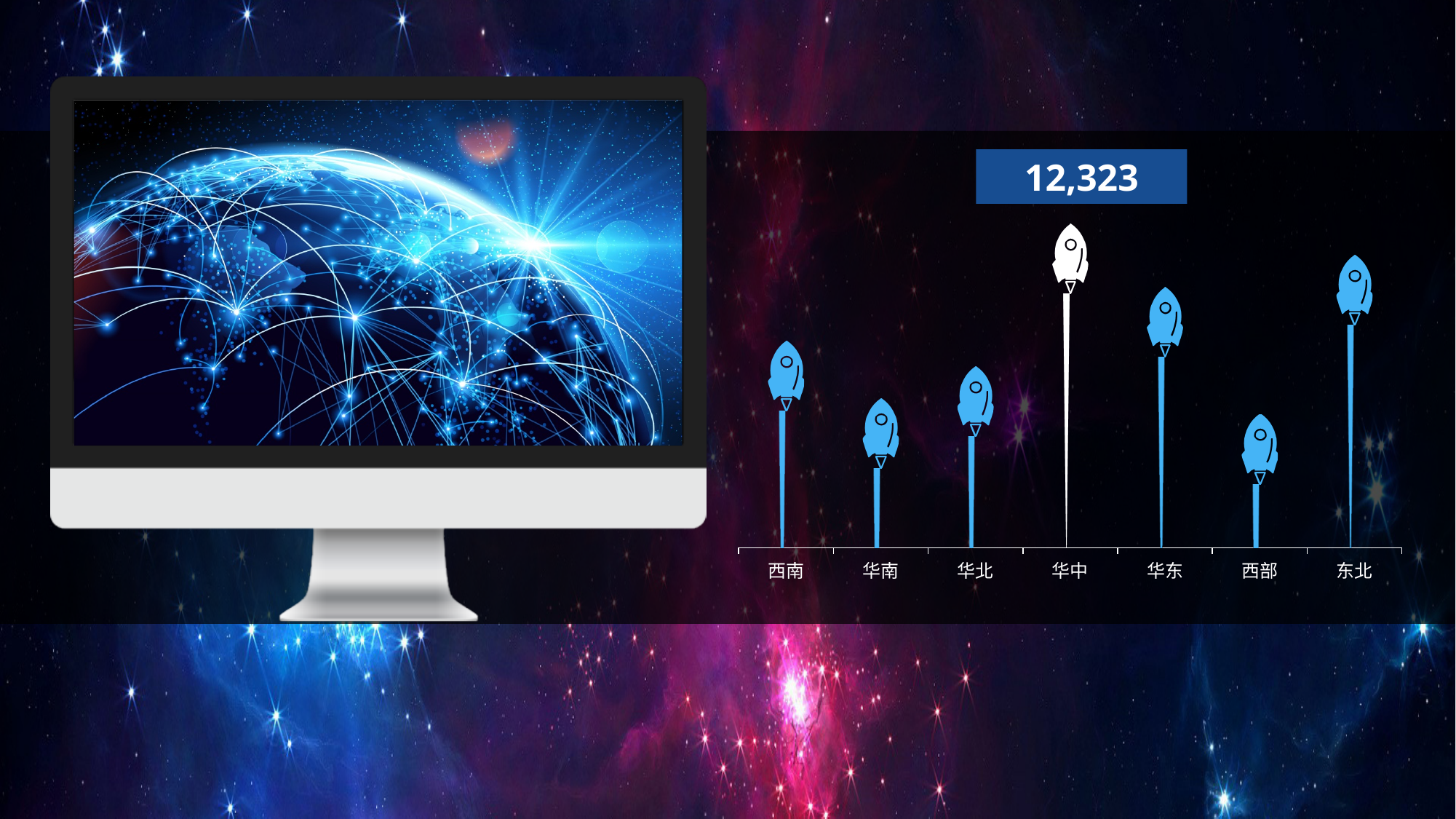
Which is larger, the value for 华北 or the value for 西部? 华北 What colour is the rocket icon above the 华中 bar? White What value is shown for 华中? 12,323 Which category has the highest value? 华中 What kind of chart is shown on the slide? Bar chart Which is larger, the value for 华中 or the value for 东北? 华中 Which category has the lowest value? 西部 How many categories are shown on the x axis? 7 Which is larger, the value for 东北 or the value for 华东? 东北 Which category is the only one whose value is printed on the chart? 华中